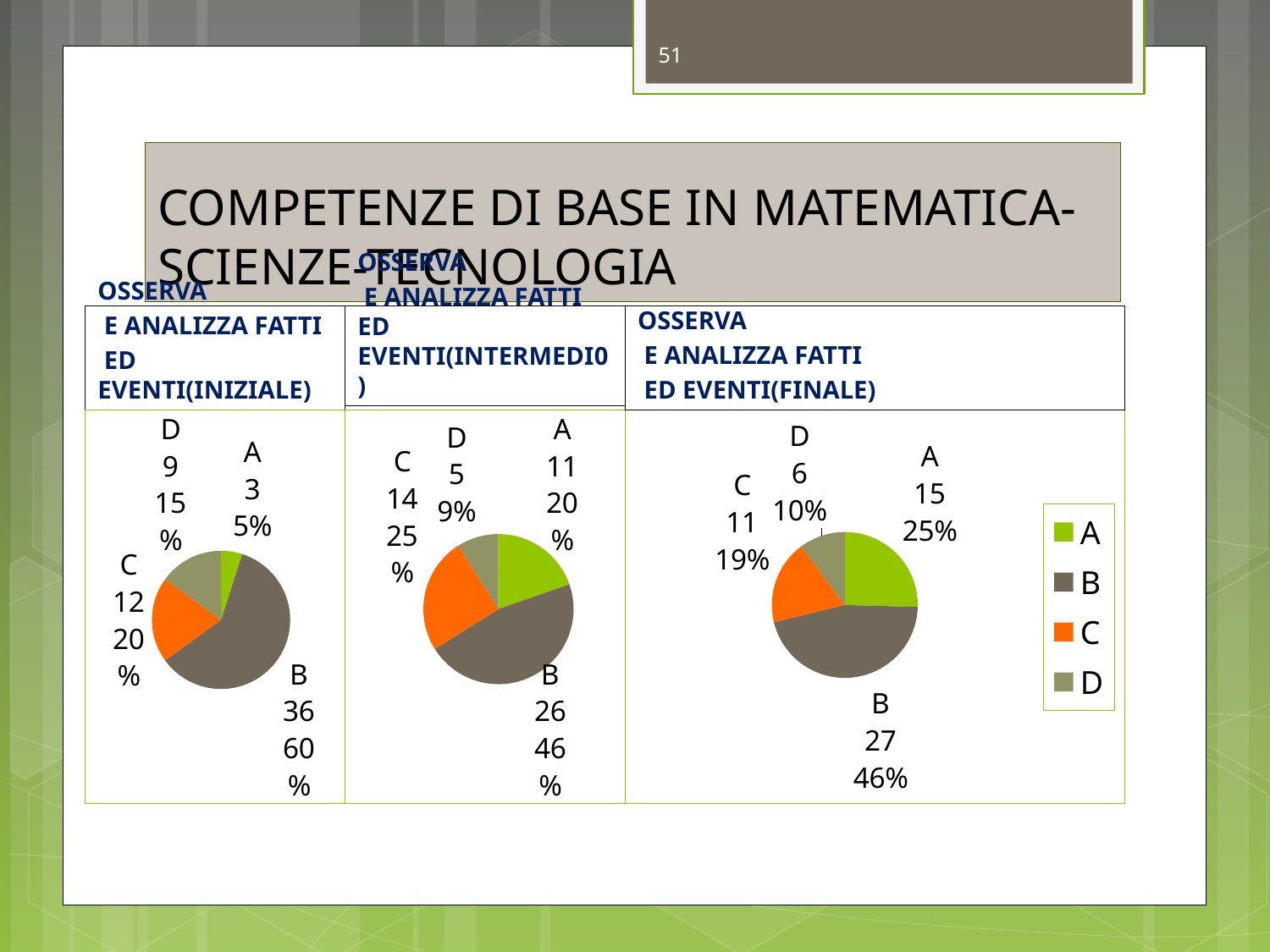
In the right pie chart (FINALE), which is larger, the share for C or the share for D? C In the right pie chart (FINALE), what is the difference between the counts for B and A? 12 In the right pie chart (FINALE), what percentage is shown for category A? 25% In the left pie chart (INIZIALE), what count is shown for category C? 12 In the middle pie chart (INTERMEDIO), what count is shown for category D? 5 What type of chart is used on this slide? Pie chart How many categories does the legend on the right list? 4 In the left pie chart (INIZIALE), which category has the smallest share? A In the right pie chart (FINALE), what count is shown for category B? 27 In the middle pie chart (INTERMEDIO), what percentage is shown for category C? 25% In the middle pie chart (INTERMEDIO), which category has the largest share? B In the left pie chart (INIZIALE), what percentage is shown for category B? 60%